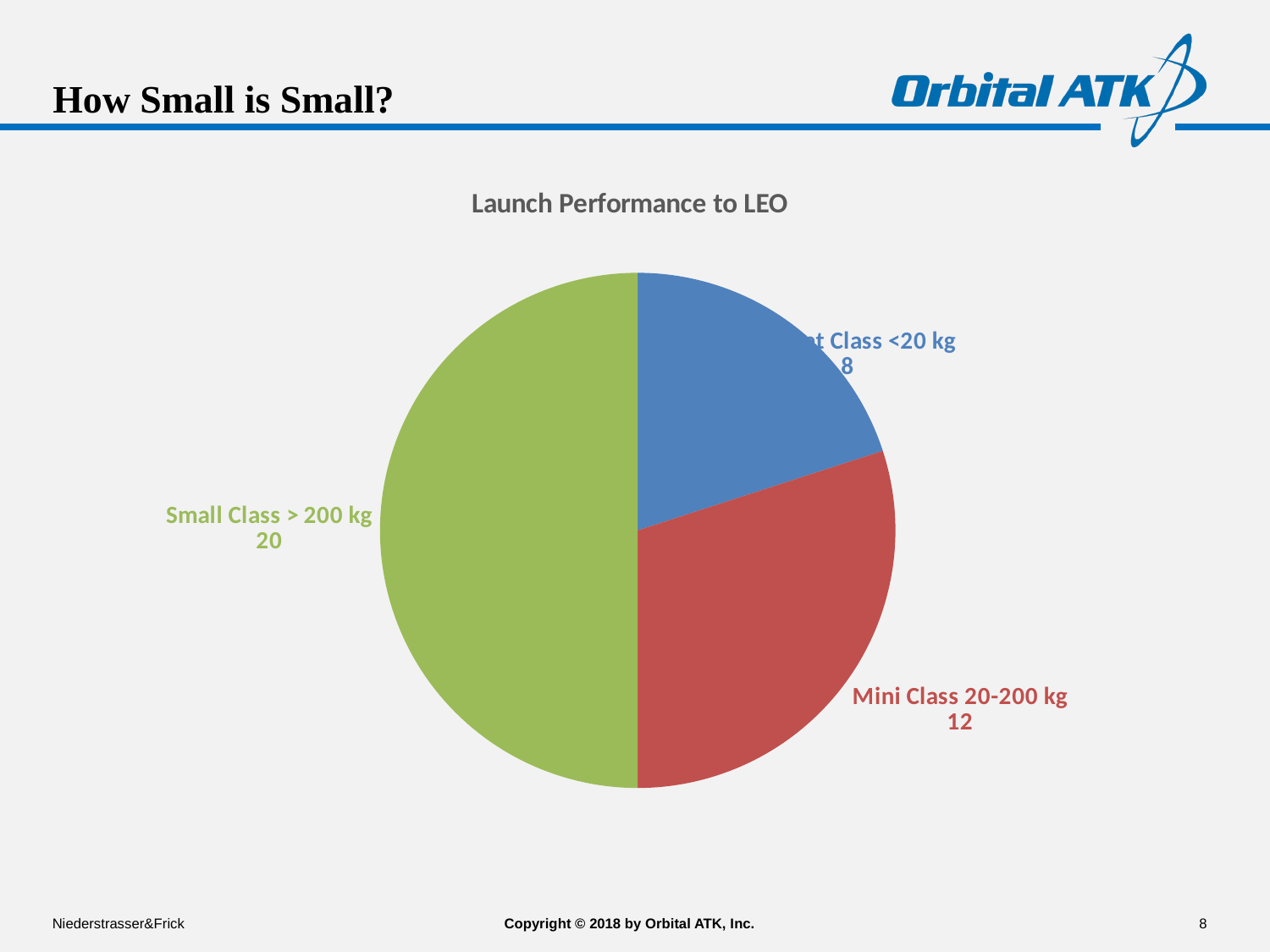
What share of the pie does Small Class > 200 kg represent? 50% What is the title of the chart? Launch Performance to LEO What colour is the slice for Mini Class 20-200 kg? Red What is the difference between the values for Small Class > 200 kg and Mini Class 20-200 kg? 8 What type of chart is shown on the slide? Pie chart What is the value for Mini Class 20-200 kg? 12 Which category has the largest slice of the pie? Small Class > 200 kg Which is larger, the value for Small Class > 200 kg or the value for Mini Class 20-200 kg? Small Class > 200 kg How many slices does the pie chart have? 3 What is the total of all the values shown in the pie chart? 40 What share of the pie does Mini Class 20-200 kg represent? 30% What is the value for Small Class > 200 kg? 20